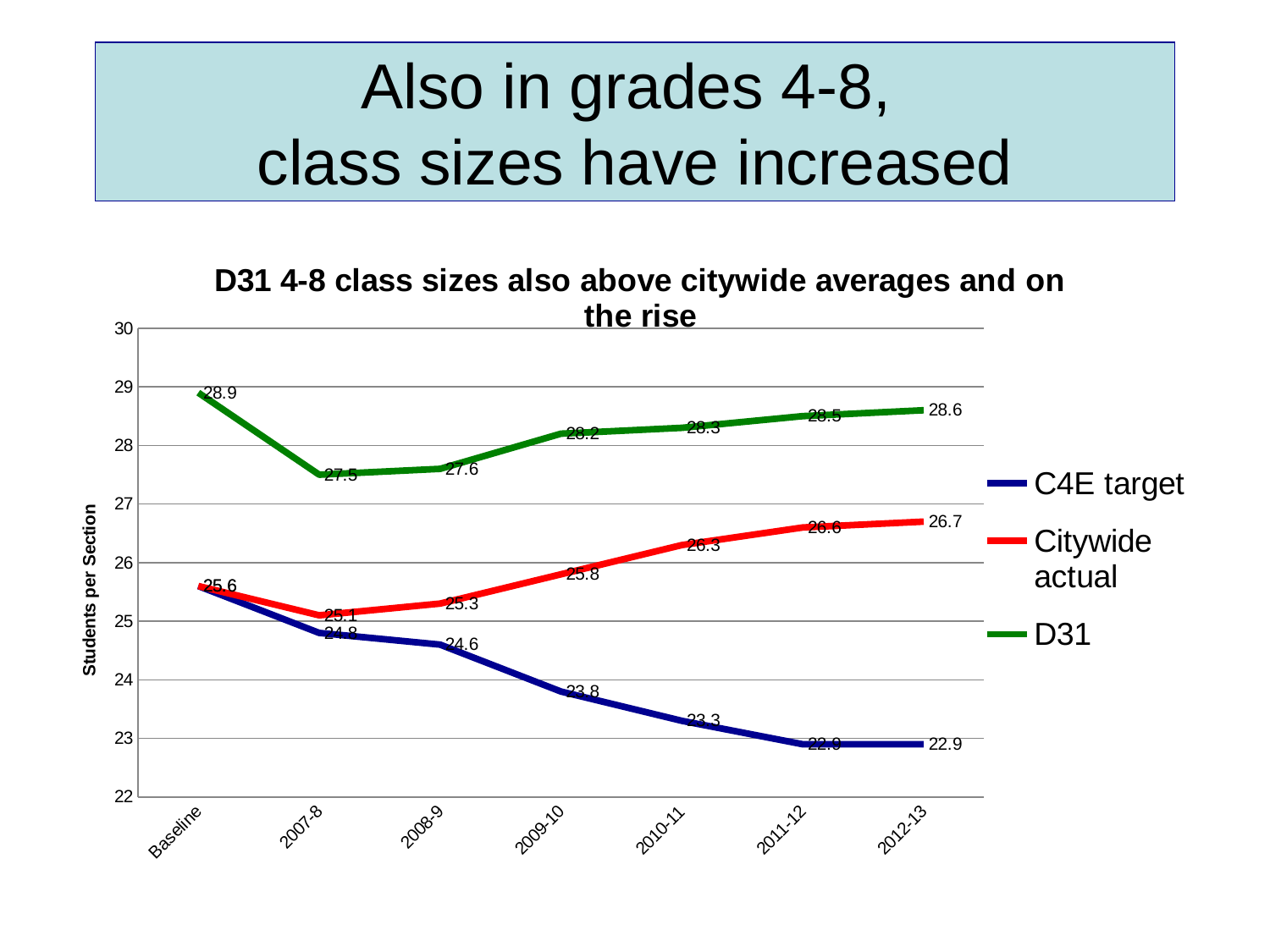
What kind of chart is shown on the slide? line chart What is the D31 value at Baseline? 28.9 Does the C4E target series rise or fall from Baseline to 2012-13? fall What is the C4E target value in 2008-9? 24.6 How many series does the legend list? 3 Which series is higher in 2010-11, D31 or Citywide actual? D31 What is the Citywide actual value in 2012-13? 26.7 How many points are plotted along the x axis for each series? 7 What is the difference between the D31 value and the Citywide actual value in 2012-13? 1.9 In which year is the D31 value lowest? 2007-8 What is the D31 value in 2012-13? 28.6 What is the C4E target value in 2012-13? 22.9